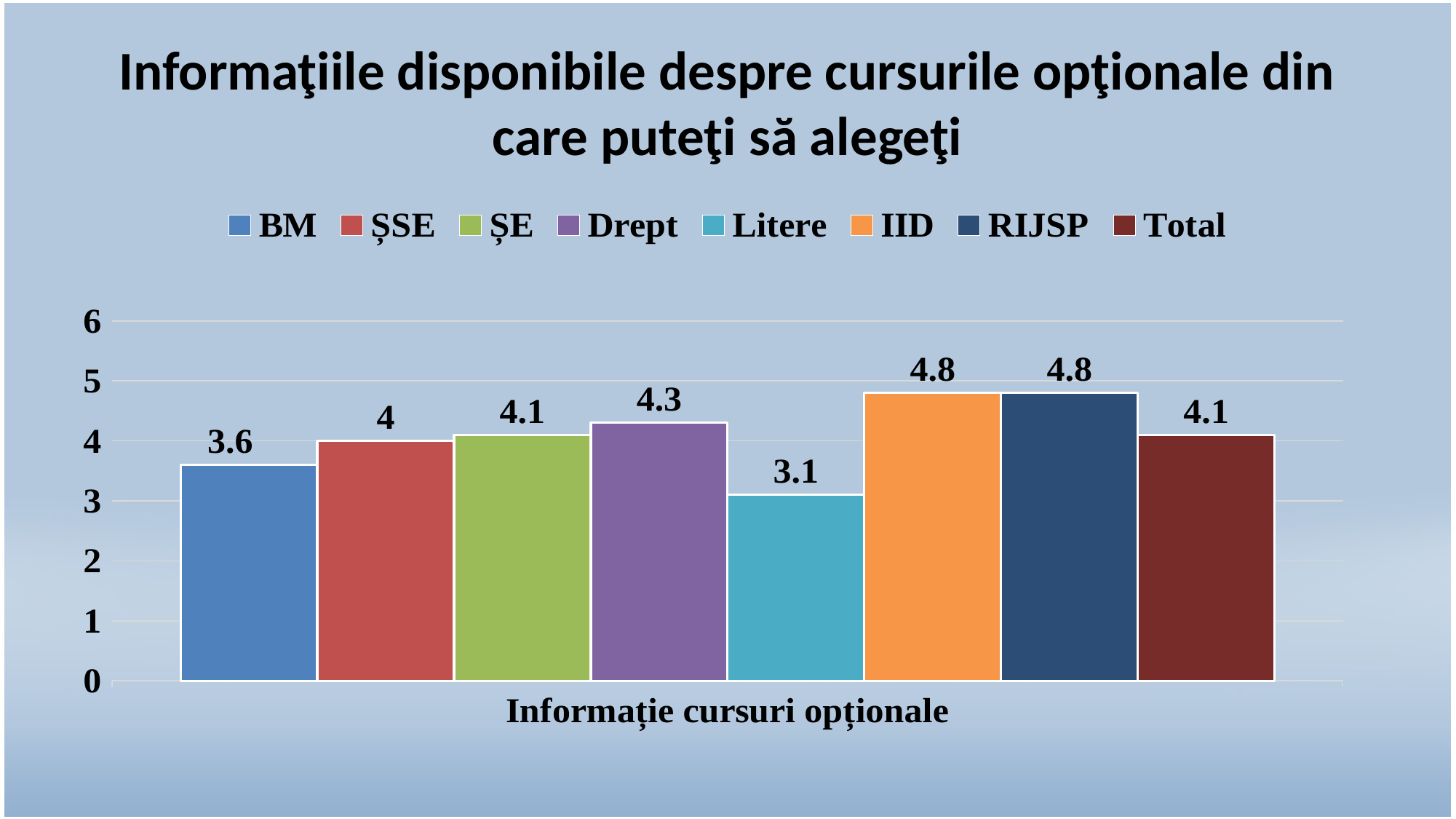
What colour is the bar for IID? orange Which series has the lowest value? Litere What kind of chart is shown on the slide? bar chart What is the value for Litere? 3.1 What is the value for BM? 3.6 How many series does the legend list? 8 Is the value for Litere greater or less than 4? less What is the value for Drept? 4.3 What is the value for Total? 4.1 Which is larger, the value for ȘSE or the value for Drept? Drept What is the x-axis label of the chart? Informație cursuri opționale What is the difference between the values for IID and BM? 1.2